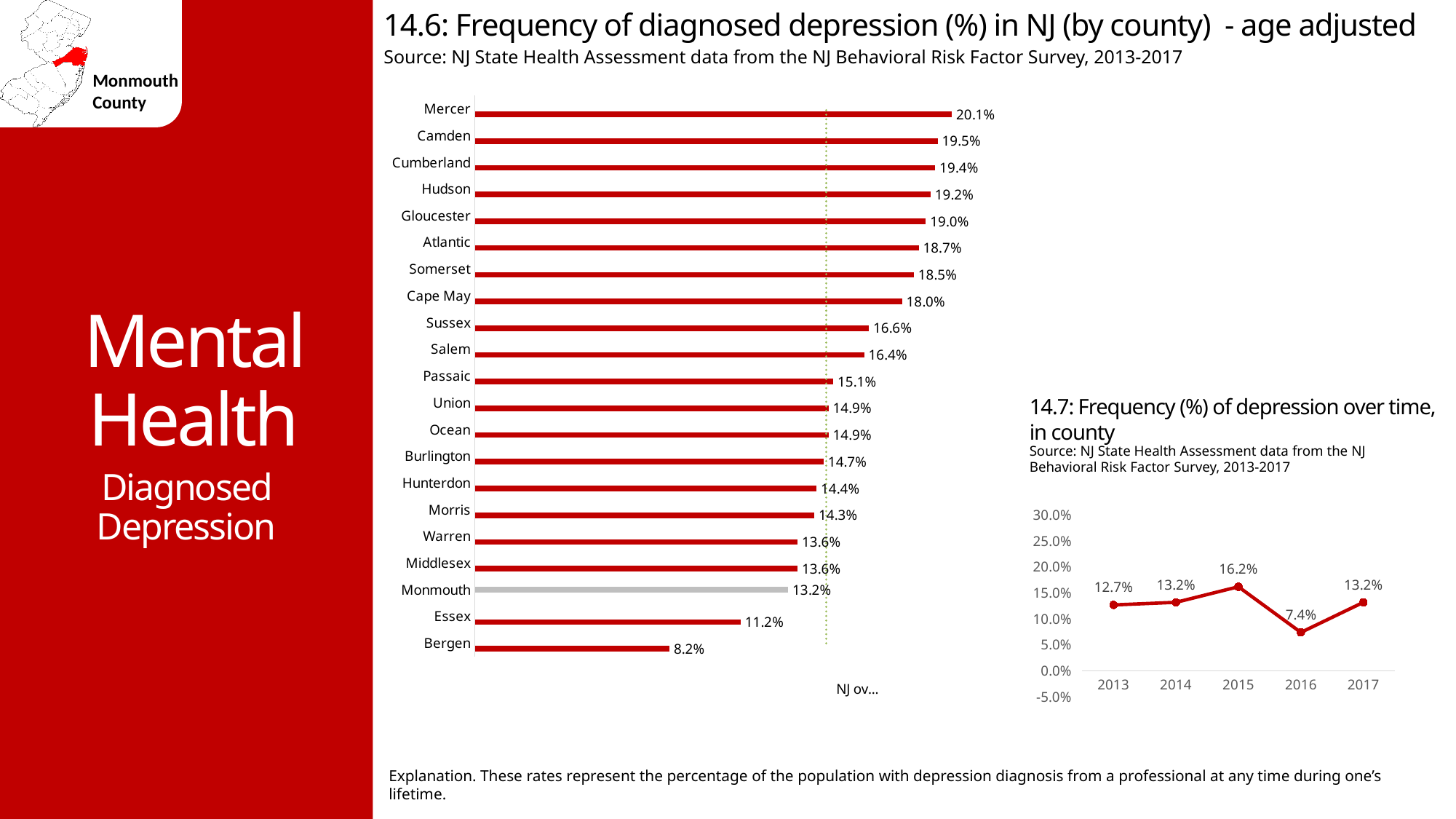
In chart 14.6, which county has the lowest frequency of diagnosed depression? Bergen In chart 14.6, how many counties are shown? 21 In chart 14.7, which year has the highest frequency of depression? 2015 In chart 14.6, which county has the highest frequency of diagnosed depression? Mercer In chart 14.7, what is the difference between the 2015 and 2016 values? 8.8% What kind of chart is chart 14.6? Bar chart What kind of chart is chart 14.7? Line chart In chart 14.6, what is the difference between the values for Mercer and Bergen? 11.9% In chart 14.7, what is the frequency of depression in 2016? 7.4% In chart 14.6, what is the value for Essex? 11.2% In chart 14.6, what is the frequency of diagnosed depression for Monmouth? 13.2% In chart 14.6, which county has a higher value, Hudson or Cape May? Hudson